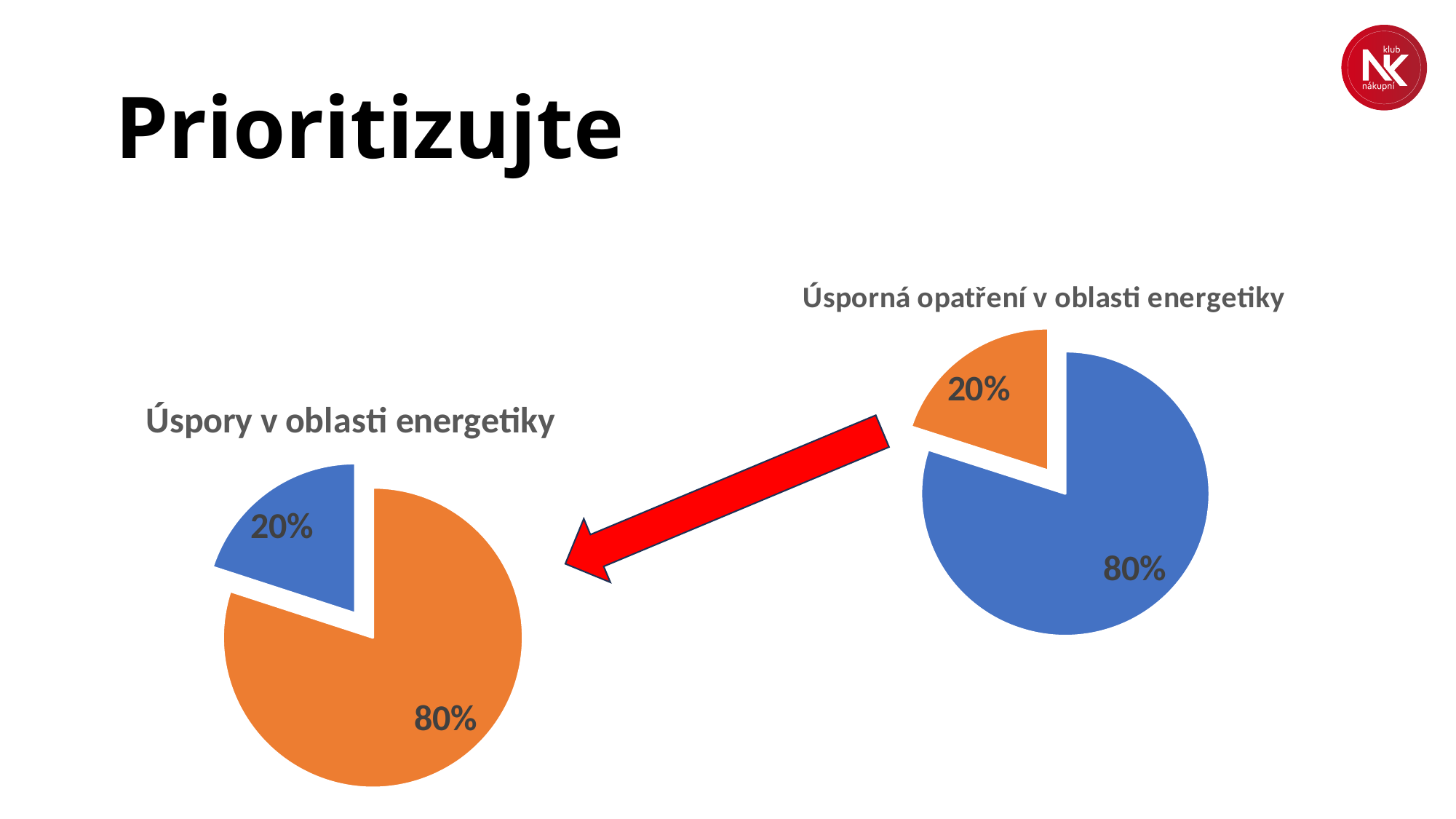
In the chart titled "Úspory v oblasti energetiky", what share does the blue slice have? 20% In the chart titled "Úsporná opatření v oblasti energetiky", which colour slice is the smallest? orange What kind of chart is the chart titled "Úsporná opatření v oblasti energetiky"? pie chart What is the title of the pie chart on the left of the slide? Úspory v oblasti energetiky In the chart titled "Úspory v oblasti energetiky", which colour slice is the largest? orange In the chart titled "Úspory v oblasti energetiky", what share does the orange slice have? 80% In the chart titled "Úsporná opatření v oblasti energetiky", what share does the blue slice have? 80% What kind of chart is the chart titled "Úspory v oblasti energetiky"? pie chart How many slices does the chart titled "Úspory v oblasti energetiky" have? 2 In the chart titled "Úspory v oblasti energetiky", what is the difference between the orange slice and the blue slice? 60% How many slices does the chart titled "Úsporná opatření v oblasti energetiky" have? 2